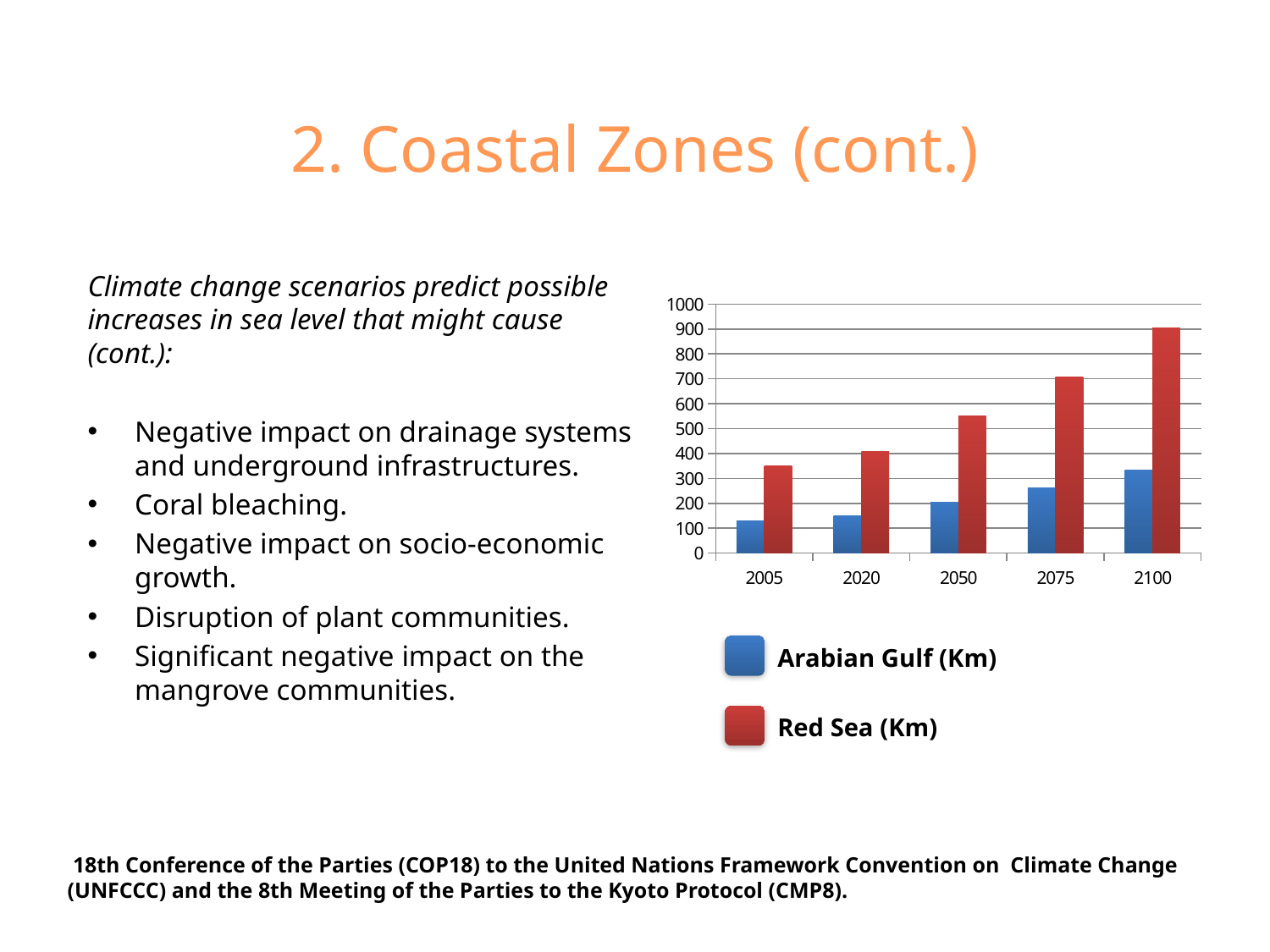
Do the Red Sea (Km) values rise or fall from 2005 to 2100? rise How many series does the chart legend list? 2 Is the Red Sea (Km) value for 2005 greater or less than 400? less Is the Arabian Gulf (Km) value for 2100 greater or less than 300? greater Is the Arabian Gulf (Km) value for 2005 greater or less than 200? less What kind of chart is shown on the slide? bar chart How many years are shown on the x axis of the chart? 5 Which year has the highest Red Sea (Km) value? 2100 Which year has the lowest Arabian Gulf (Km) value? 2005 What colour are the bars for the Red Sea (Km) series? red Which series has the larger value in 2050, Arabian Gulf (Km) or Red Sea (Km)? Red Sea (Km)